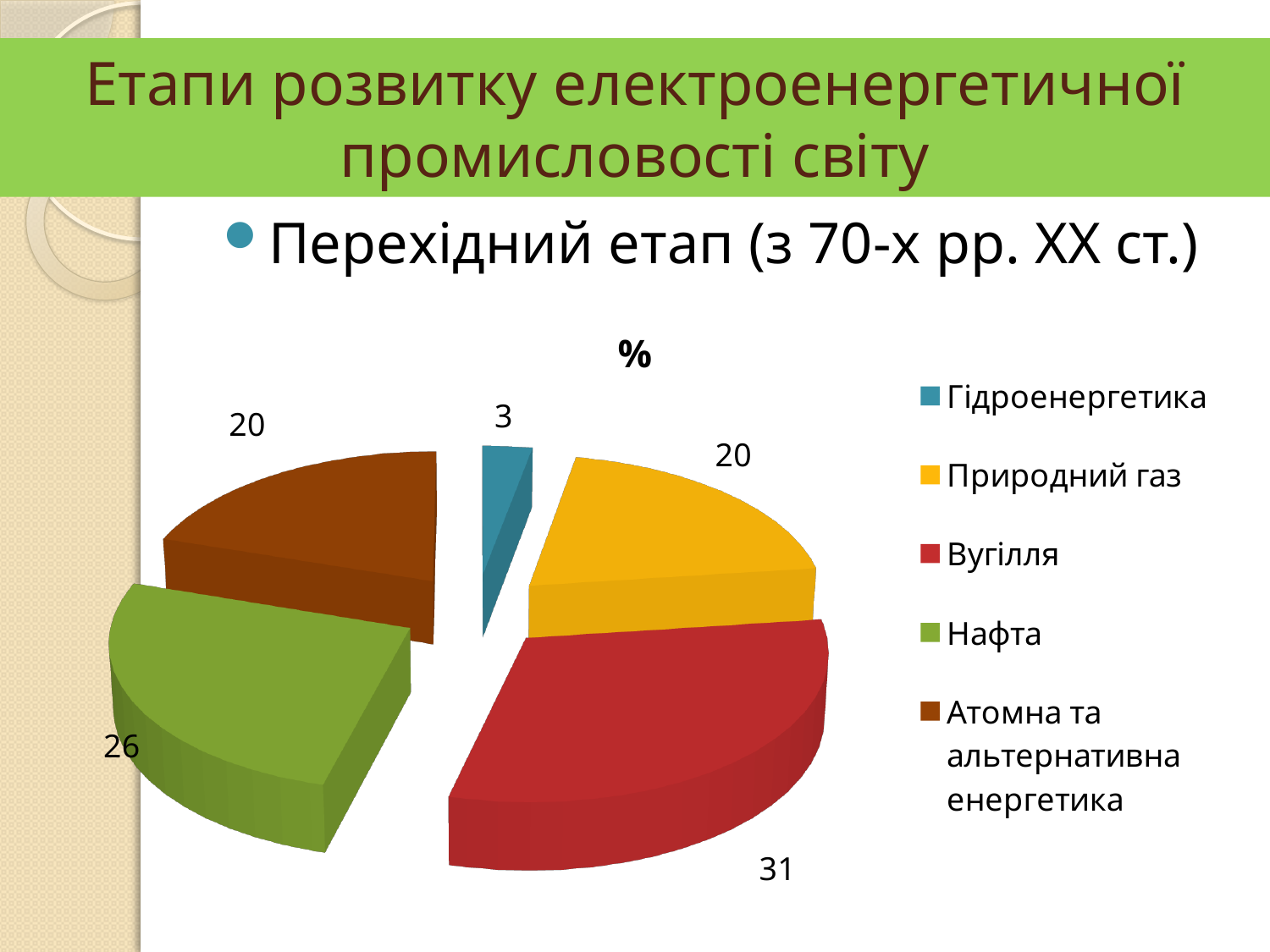
What is the value for Природний газ in the pie chart? 20 How many categories does the pie chart have? 5 What is the value for Вугілля in the pie chart? 31 What is the value for Нафта in the pie chart? 26 What colour is the slice for Атомна та альтернативна енергетика? brown What is the title of the pie chart? % Which category has the smallest slice in the pie chart? Гідроенергетика Which category has the largest slice in the pie chart? Вугілля What kind of chart is shown on the slide? pie chart Which is larger, the value for Нафта or the value for Природний газ? Нафта What is the difference between the values for Вугілля and Нафта? 5 What is the value for Гідроенергетика in the pie chart? 3